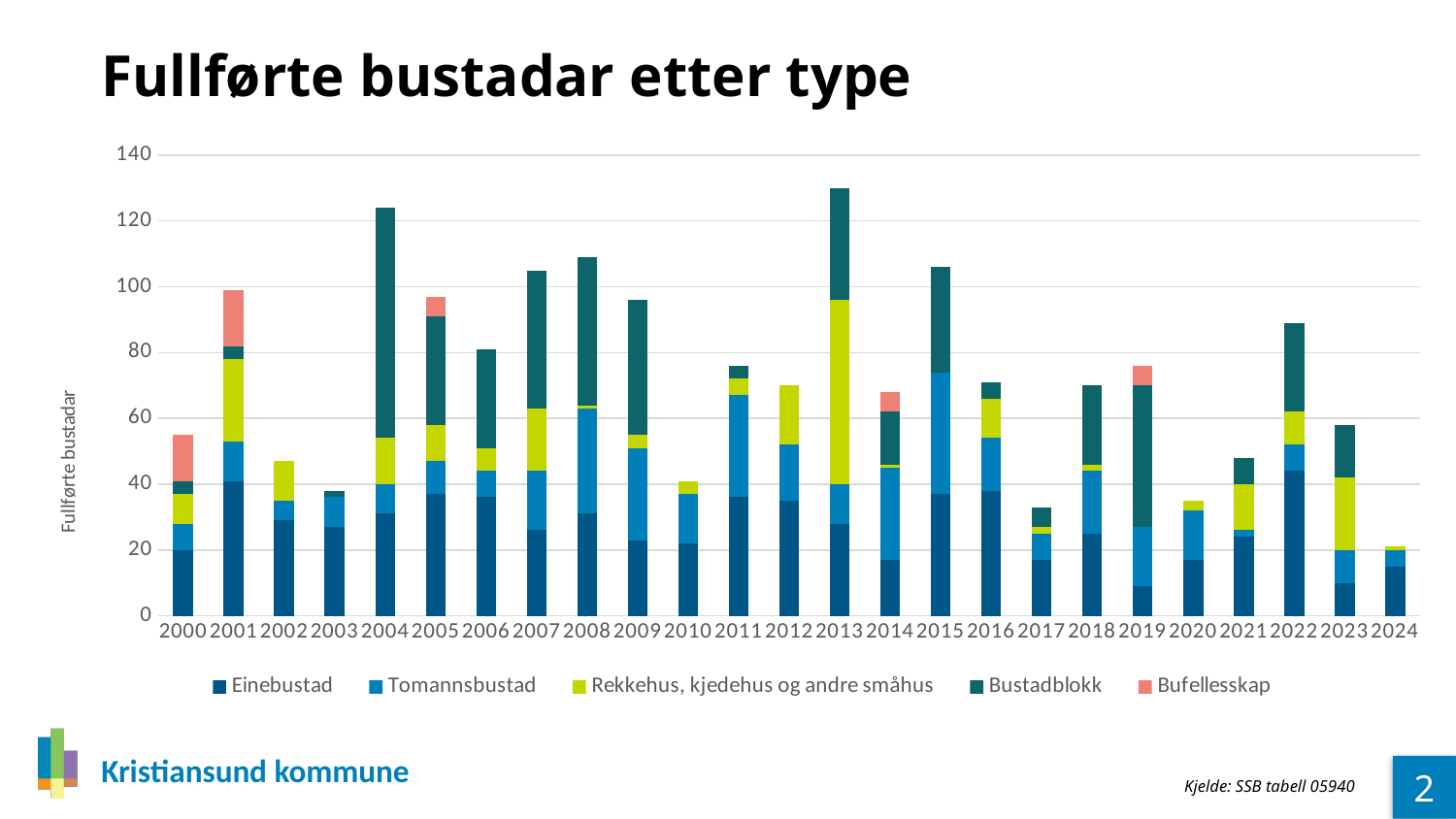
What is the title of the chart? Fullførte bustadar etter type Which year has the lowest total of completed dwellings? 2024 How many years are shown along the x axis? 25 Is the total value for 2015 greater or less than 100? greater Is the total value for 2010 greater or less than 60? less Is the total value for 2013 greater or less than 120? greater Which year has a larger total, 2015 or 2016? 2015 Which year has the highest total of completed dwellings? 2013 What type of chart is shown on the slide? Stacked bar chart Which legend entry is shown in light red/salmon? Bufellesskap How many series does the legend list? 5